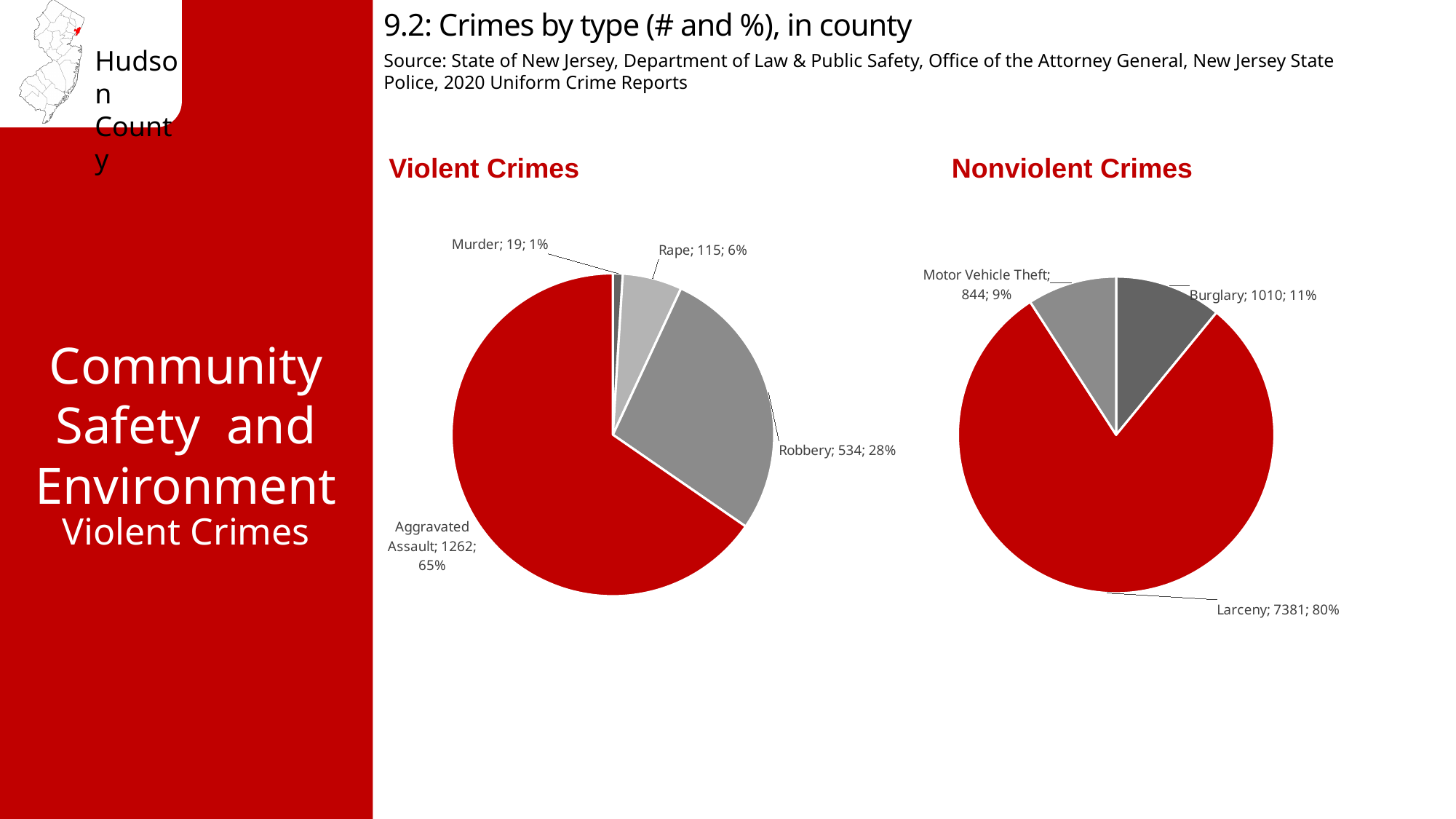
In the Nonviolent Crimes chart, which is larger, Burglary or Motor Vehicle Theft? Burglary In the Violent Crimes chart, which category has the largest slice? Aggravated Assault In the Violent Crimes chart, what share of the pie is Robbery? 28% In the Violent Crimes chart, how many categories are shown? 4 What kind of chart is the Nonviolent Crimes chart? Pie chart In the Nonviolent Crimes chart, what is the difference between the number of burglaries and the number of motor vehicle thefts? 166 In the Violent Crimes chart, what is the difference between the number of robberies and the number of rapes? 419 In the Nonviolent Crimes chart, how many larcenies are shown? 7381 In the Violent Crimes chart, how many aggravated assaults are shown? 1262 In the Nonviolent Crimes chart, what share of the pie is Motor Vehicle Theft? 9% What is the title of the chart on the right side of the slide? Nonviolent Crimes In the Violent Crimes chart, which category has the smallest slice? Murder